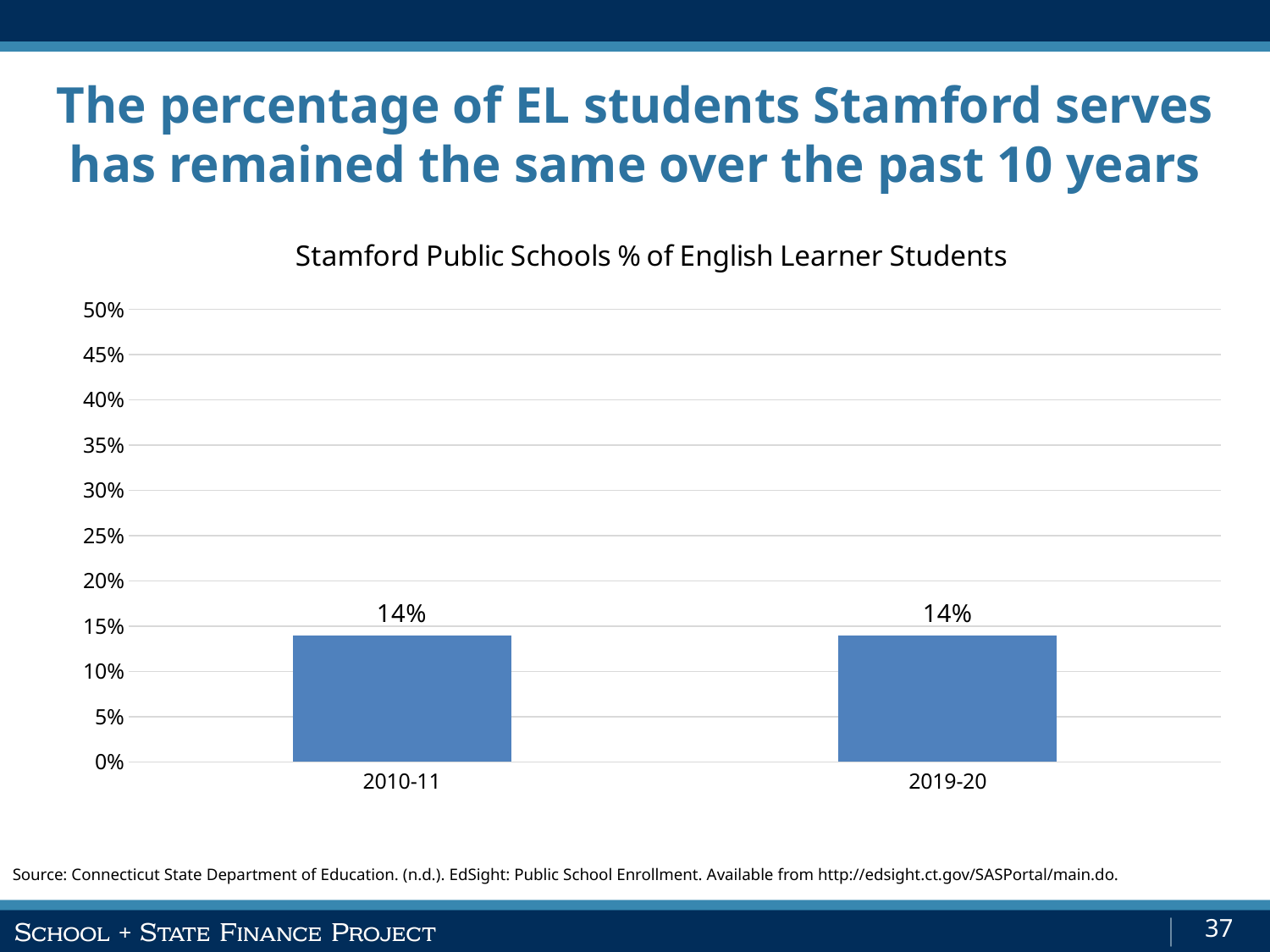
What is the difference between the 2019-20 value and the 2010-11 value? 0% Is the value for 2019-20 greater or less than 10%? greater What kind of chart is shown on the slide? Bar chart What is the percentage of English Learner students in Stamford Public Schools for 2019-20? 14% What is the highest value shown on the y axis of the chart? 50% What is the percentage of English Learner students in Stamford Public Schools for 2010-11? 14% How many categories are shown on the x axis of the chart? 2 Do the values rise, fall, or stay the same from 2010-11 to 2019-20? Stay the same What is the title of the chart? Stamford Public Schools % of English Learner Students Is the value for 2010-11 greater or less than 20%? less